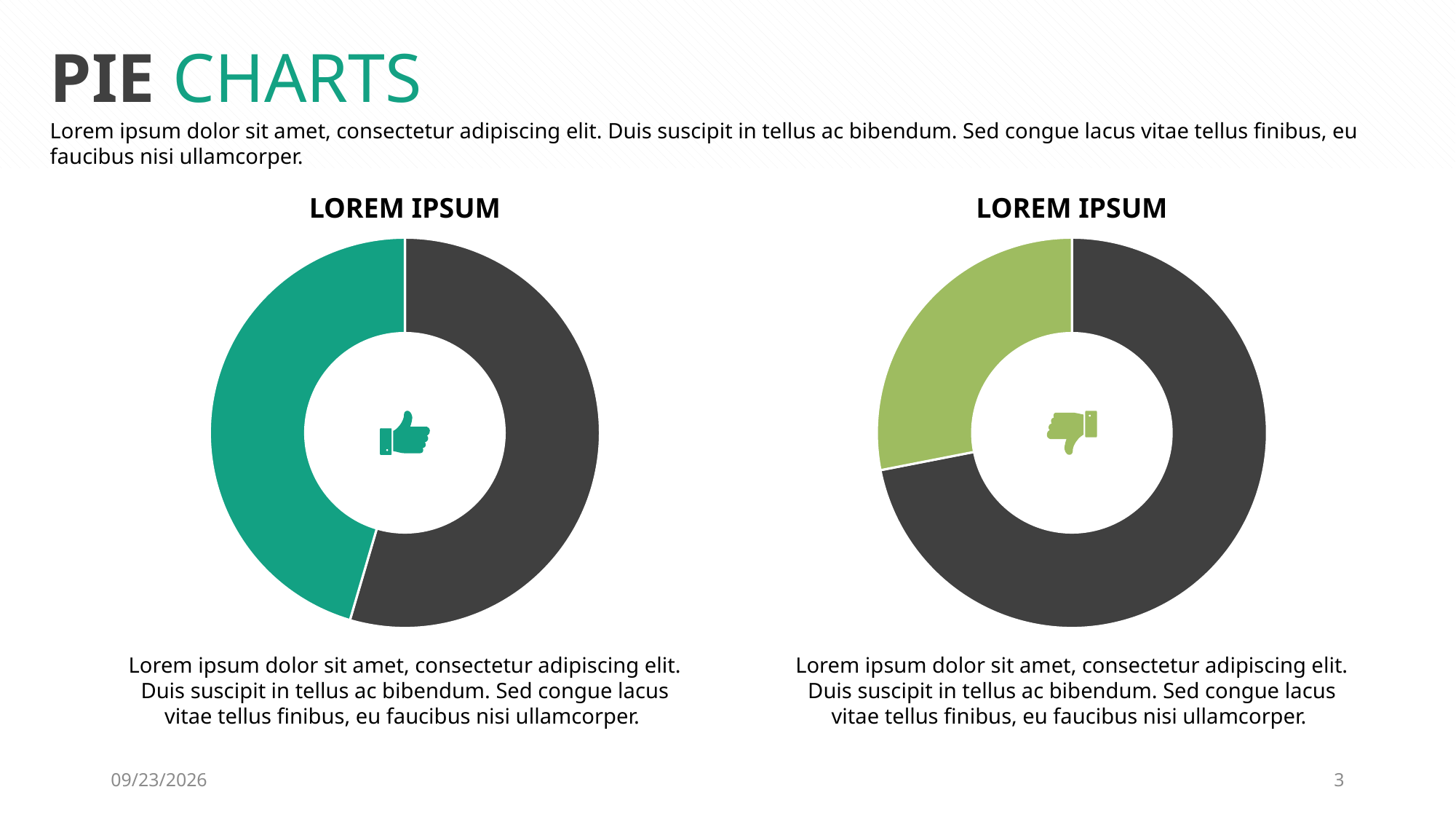
In the left chart, is the dark grey slice greater or less than half of the pie? greater What is the title of the left chart? LOREM IPSUM In the right chart, is the light green slice greater or less than half of the pie? less What icon is shown in the centre of the right chart? A thumbs-down icon How many slices does the left chart have? 2 In the right chart, which slice is larger, the dark grey one or the light green one? The dark grey one What kind of chart is the right chart on the slide? Pie chart (donut) What kind of chart is the left chart on the slide? Pie chart (donut) In the left chart, which slice is larger, the dark grey one or the teal one? The dark grey one How many slices does the right chart have? 2